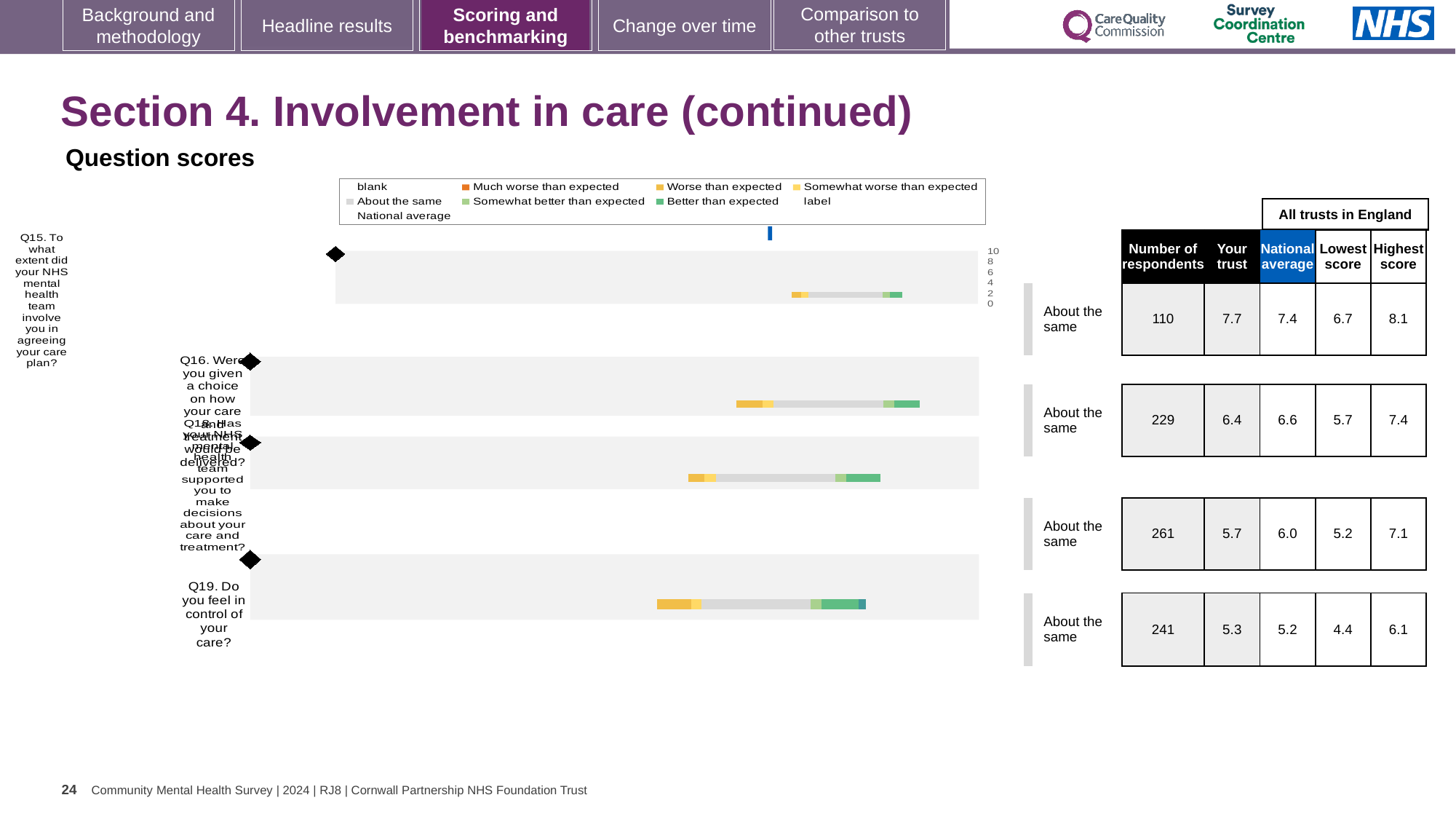
What is the 'Your trust' score for Q15 (involving you in agreeing your care plan)? 7.7 What is the lowest score among all trusts in England for Q15? 6.7 What benchmark category is shown for all four questions on this slide? About the same Which question has the lowest 'Your trust' score? Q19 How many respondents answered Q16? 229 What is the difference between the 'Your trust' score and the national average for Q19? 0.1 What kind of chart is used to show the question scores on this slide? bar chart What is the difference between the highest score and the lowest score for Q18? 1.9 How many questions are plotted in the question scores chart? 4 For Q16, which is larger: the 'Your trust' score or the national average? National average Which question has the highest 'Your trust' score? Q15 What is the national average score for Q19 (feeling in control of your care)? 5.2